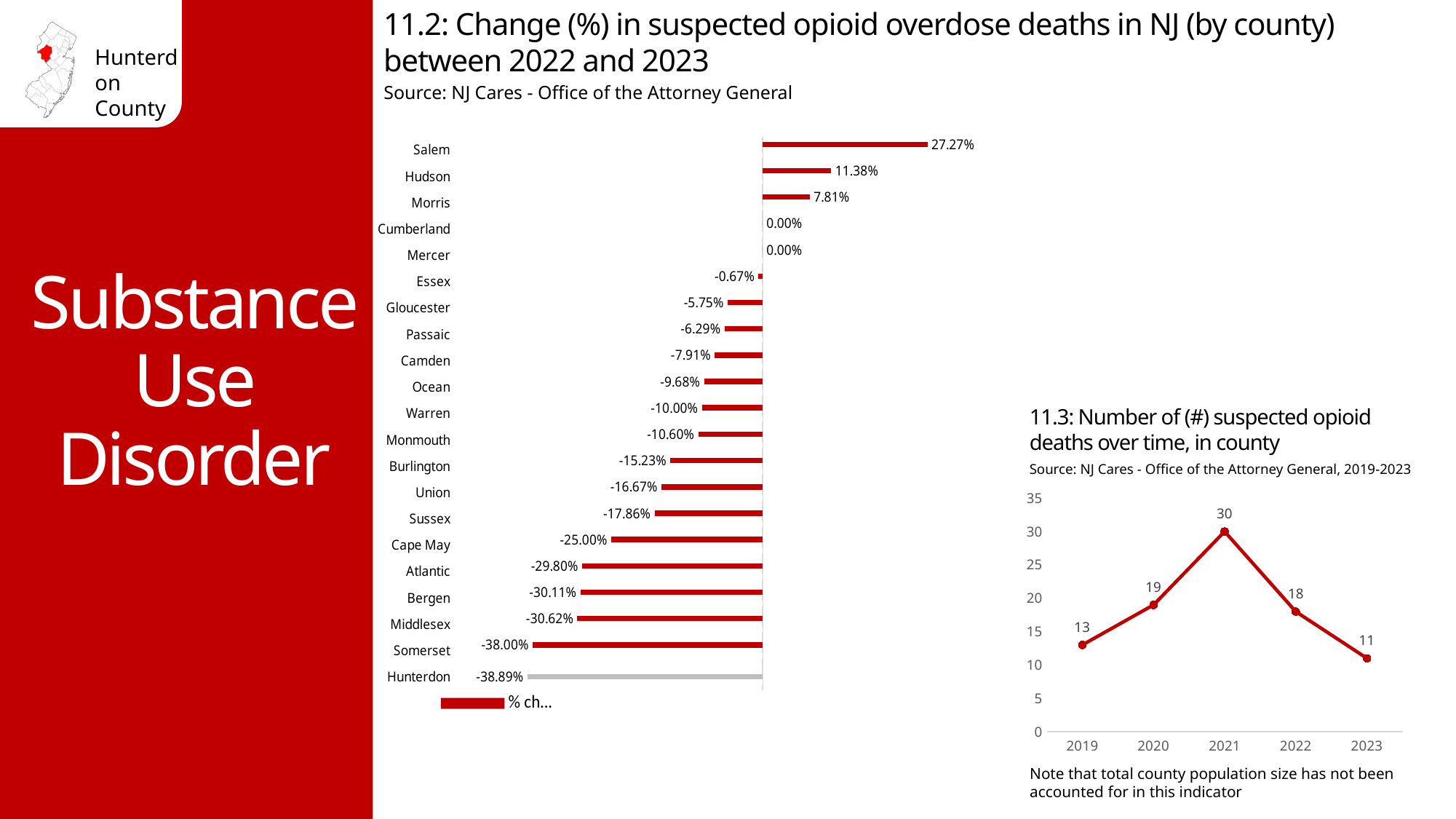
In the chart '11.2: Change (%) in suspected opioid overdose deaths in NJ (by county) between 2022 and 2023', how many counties are shown? 21 In the chart '11.2: Change (%) in suspected opioid overdose deaths in NJ (by county) between 2022 and 2023', which county has the highest value? Salem In the chart '11.2: Change (%) in suspected opioid overdose deaths in NJ (by county) between 2022 and 2023', which county has the lowest value? Hunterdon What kind of chart is '11.3: Number of (#) suspected opioid deaths over time, in county'? Line chart What kind of chart is '11.2: Change (%) in suspected opioid overdose deaths in NJ (by county) between 2022 and 2023'? Bar chart In the chart '11.2: Change (%) in suspected opioid overdose deaths in NJ (by county) between 2022 and 2023', what is the value for Hunterdon? -38.89% In the chart '11.3: Number of (#) suspected opioid deaths over time, in county', what is the difference between the values for 2021 and 2023? 19 In the chart '11.3: Number of (#) suspected opioid deaths over time, in county', do the values rise or fall from 2021 to 2023? Fall In the chart '11.2: Change (%) in suspected opioid overdose deaths in NJ (by county) between 2022 and 2023', which is larger, the value for Hudson or the value for Morris? Hudson In the chart '11.3: Number of (#) suspected opioid deaths over time, in county', which year has the lowest value? 2023 In the chart '11.3: Number of (#) suspected opioid deaths over time, in county', what is the value for 2021? 30 In the chart '11.2: Change (%) in suspected opioid overdose deaths in NJ (by county) between 2022 and 2023', what is the value for Salem? 27.27%